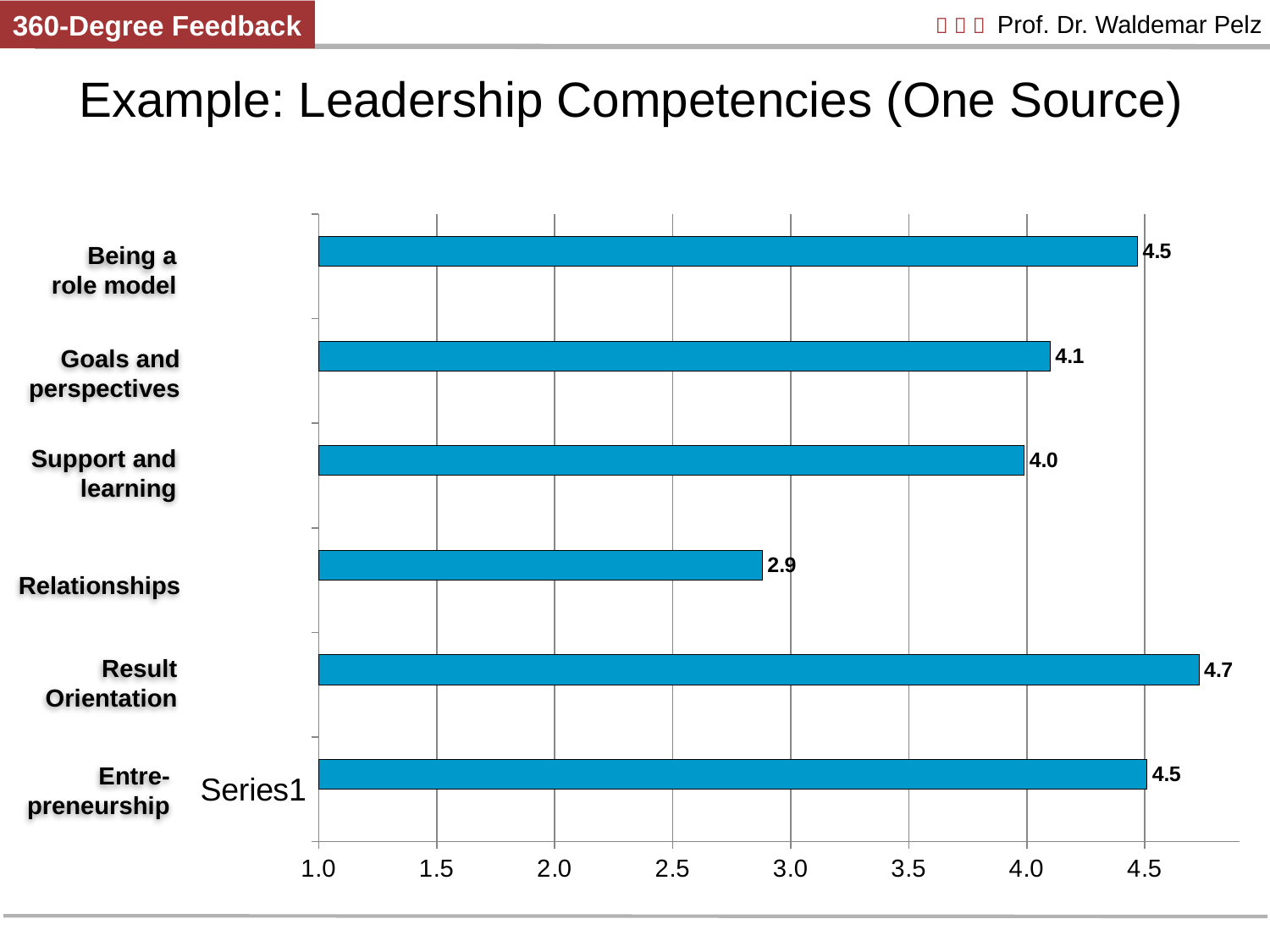
What kind of chart is shown on the slide? bar chart What is the value for Relationships? 2.9 Which competency has the highest value? Result Orientation Is the value for Relationships greater or less than 3.0? less How many competencies are shown in the chart? 6 Which competency has the lowest value? Relationships What is the value for Goals and perspectives? 4.1 What is the value for Support and learning? 4.0 What is the value for Being a role model? 4.5 What is the difference between the values for Result Orientation and Relationships? 1.8 What is the title of the slide containing the chart? Example: Leadership Competencies (One Source) Which is larger, the value for Goals and perspectives or the value for Support and learning? Goals and perspectives